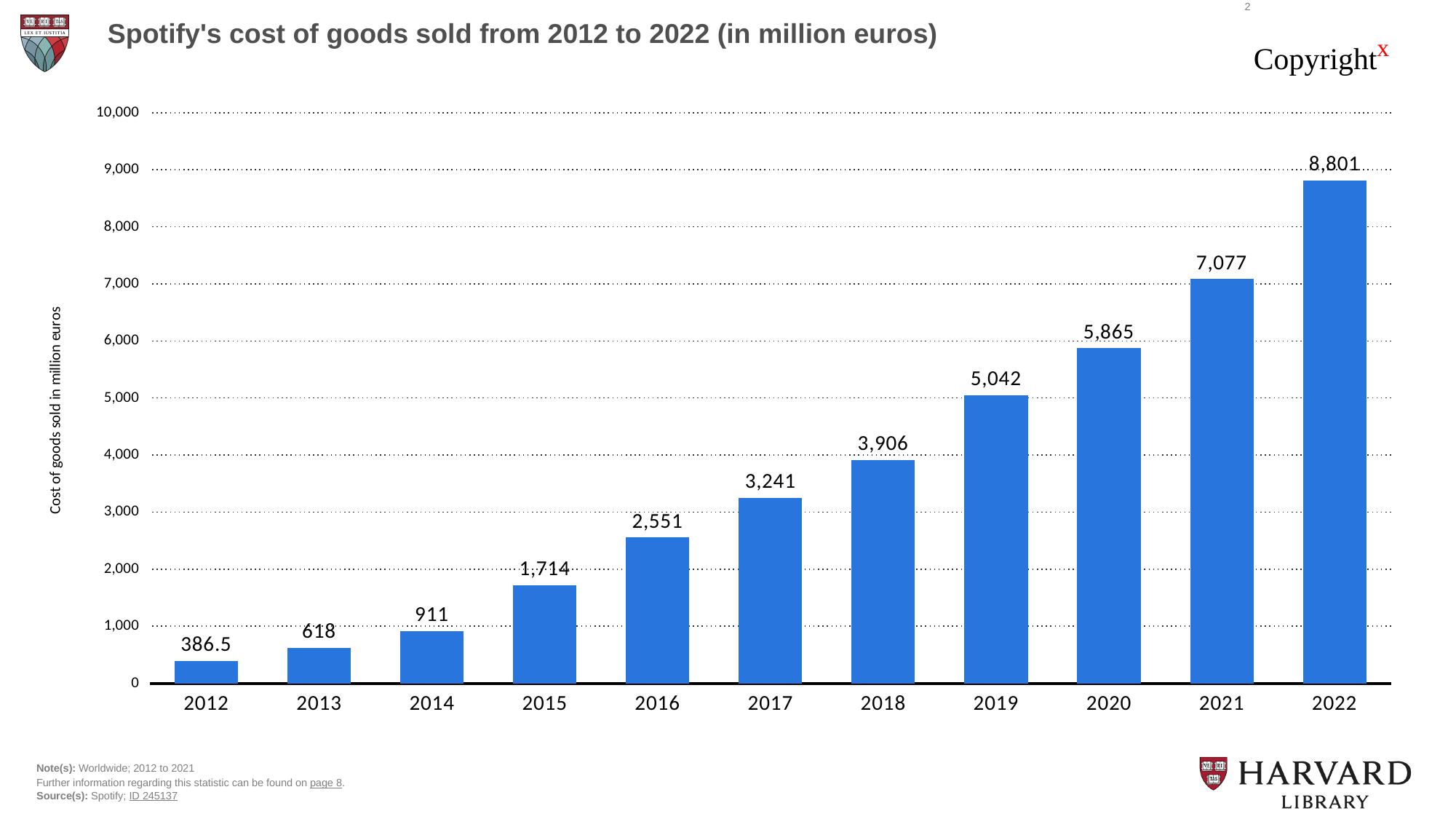
What was Spotify's cost of goods sold in 2012? 386.5 What is the difference between the cost of goods sold in 2022 and in 2021? 1,724 What is the difference between the cost of goods sold in 2016 and in 2015? 837 Do the values rise or fall from 2012 to 2022? rise What kind of chart is shown on the slide? bar chart Which year has the highest cost of goods sold? 2022 Is the value for 2020 greater or less than 6,000? less What was Spotify's cost of goods sold in 2021? 7,077 Which year had a higher cost of goods sold, 2019 or 2017? 2019 What was Spotify's cost of goods sold in 2018? 3,906 How many years are shown on the x axis? 11 Which year has the lowest cost of goods sold? 2012